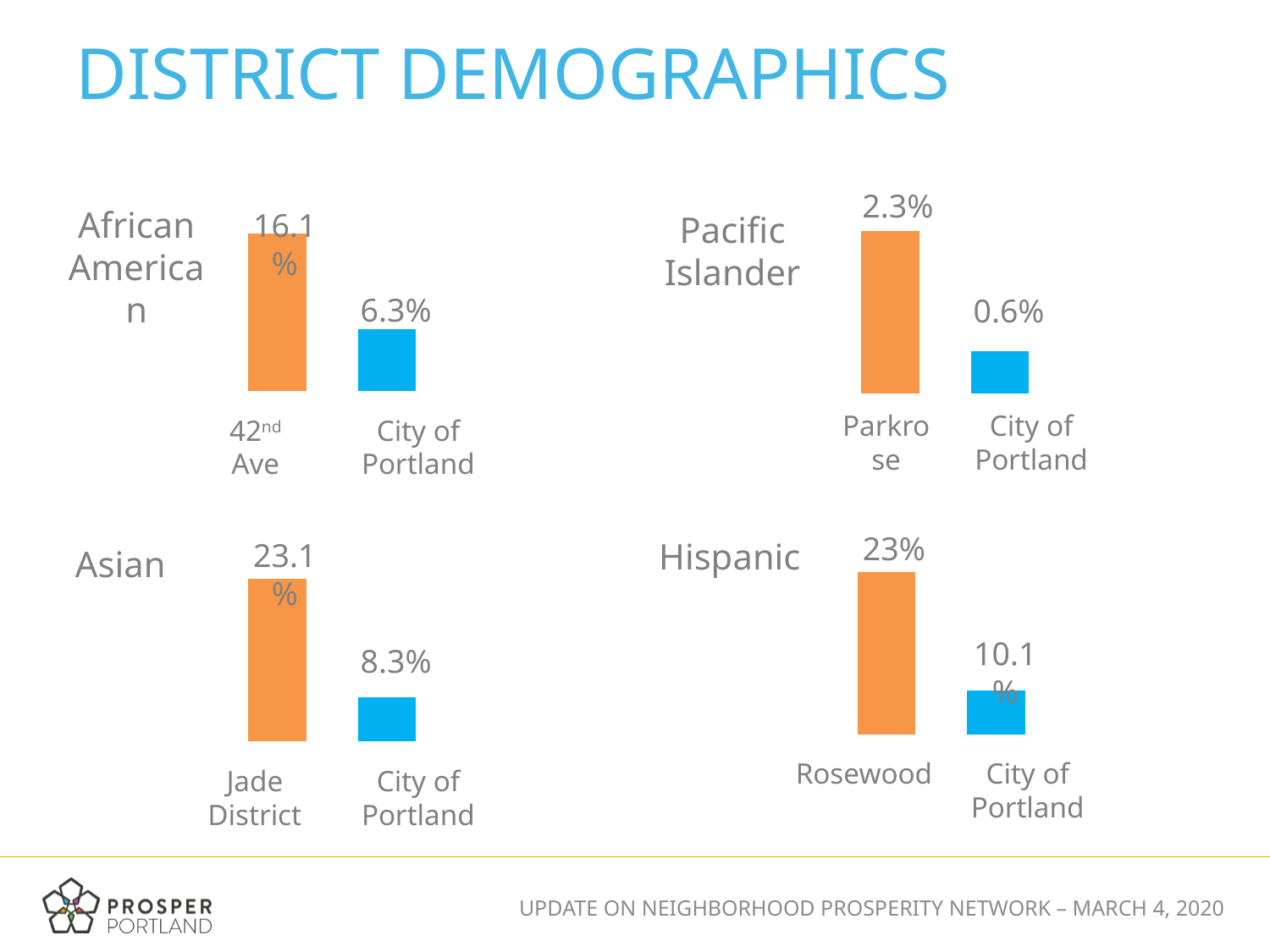
In the Hispanic chart, which is larger, Rosewood or City of Portland? Rosewood In the African American chart, what is the value for 42nd Ave? 16.1% In the Pacific Islander chart, what is the value for City of Portland? 0.6% In the African American chart, what is the value for City of Portland? 6.3% In the Pacific Islander chart, which category has the lowest value? City of Portland In the Pacific Islander chart, what is the value for Parkrose? 2.3% What kind of chart is the Asian chart? Bar chart In the Asian chart, what is the value for Jade District? 23.1% In the Hispanic chart, what is the value for Rosewood? 23% In the Asian chart, what is the difference between Jade District and City of Portland? 14.8% How many bars are in the African American chart? 2 In the Hispanic chart, what is the value for City of Portland? 10.1%